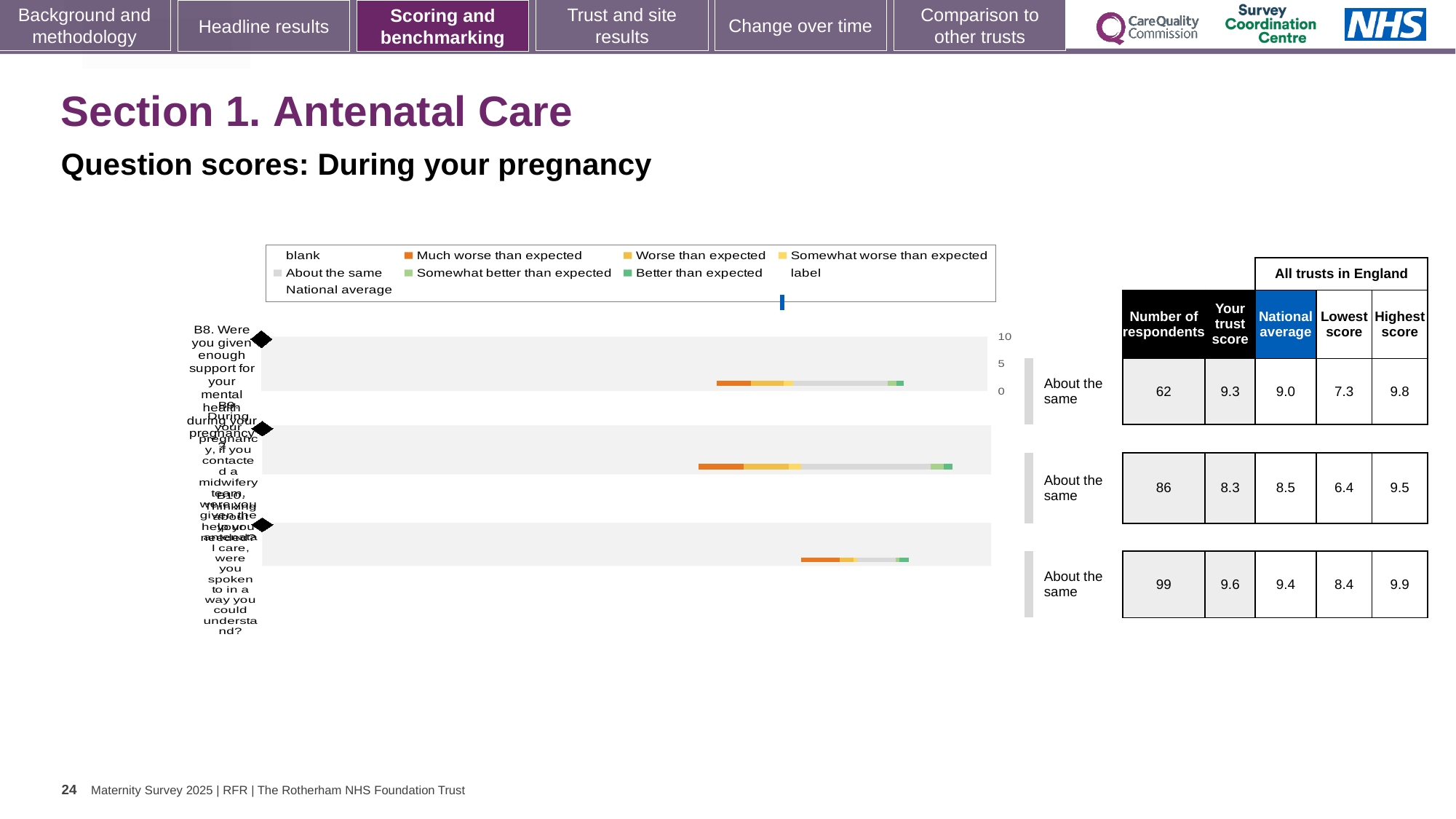
In the chart legend, what colour represents 'Much worse than expected'? orange Which question row has the lowest 'Lowest score' value, and what is it? second row, 6.4 For the first question row, what is the difference between 'Your trust score' and the national average? 0.3 For the second question row, which is larger: 'Your trust score' or the national average? national average Which question row has the highest 'Highest score' value, and what is it? third row, 9.9 What kind of chart is shown on the slide? bar chart How many question bars are plotted in the chart? 3 What benchmark category is shown next to each of the three question bars? About the same What is the national average for the third (bottom) question row? 9.4 What is the number of respondents for the first (top) question row? 62 In the chart legend, what does the blue vertical marker represent? National average What is 'Your trust score' for the second question row? 8.3